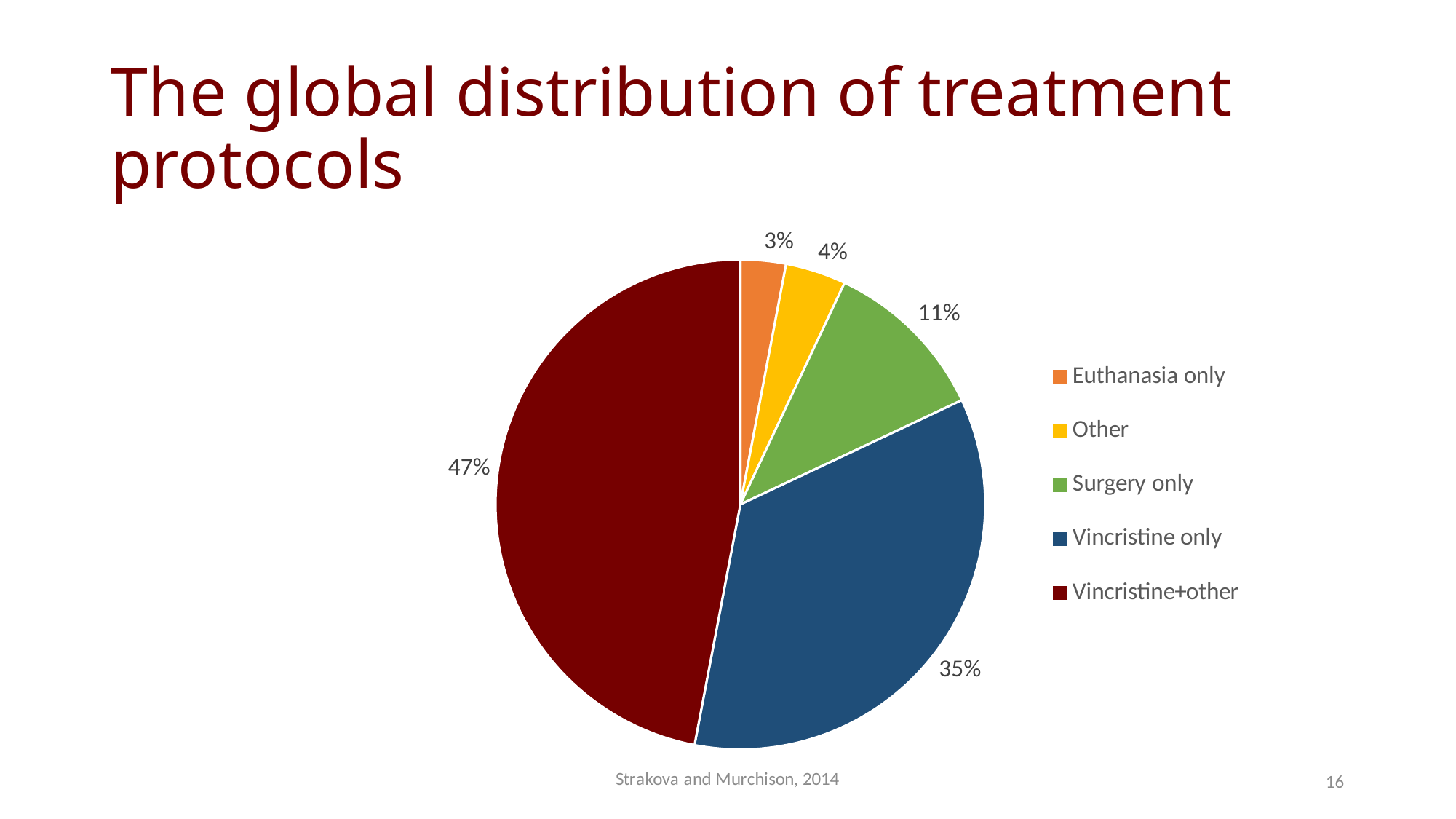
What share of the pie does Surgery only account for? 11% What colour is the slice for Surgery only? green What is the difference in percentage points between Vincristine+other and Vincristine only? 12 What share of the pie does Vincristine only account for? 35% What share of the pie does Vincristine+other account for? 47% Which category has the smallest slice of the pie? Euthanasia only What kind of chart is shown on the slide? pie chart Which is larger, the share for Surgery only or the share for Other? Surgery only Which category has the largest slice of the pie? Vincristine+other How many categories does the legend list? 5